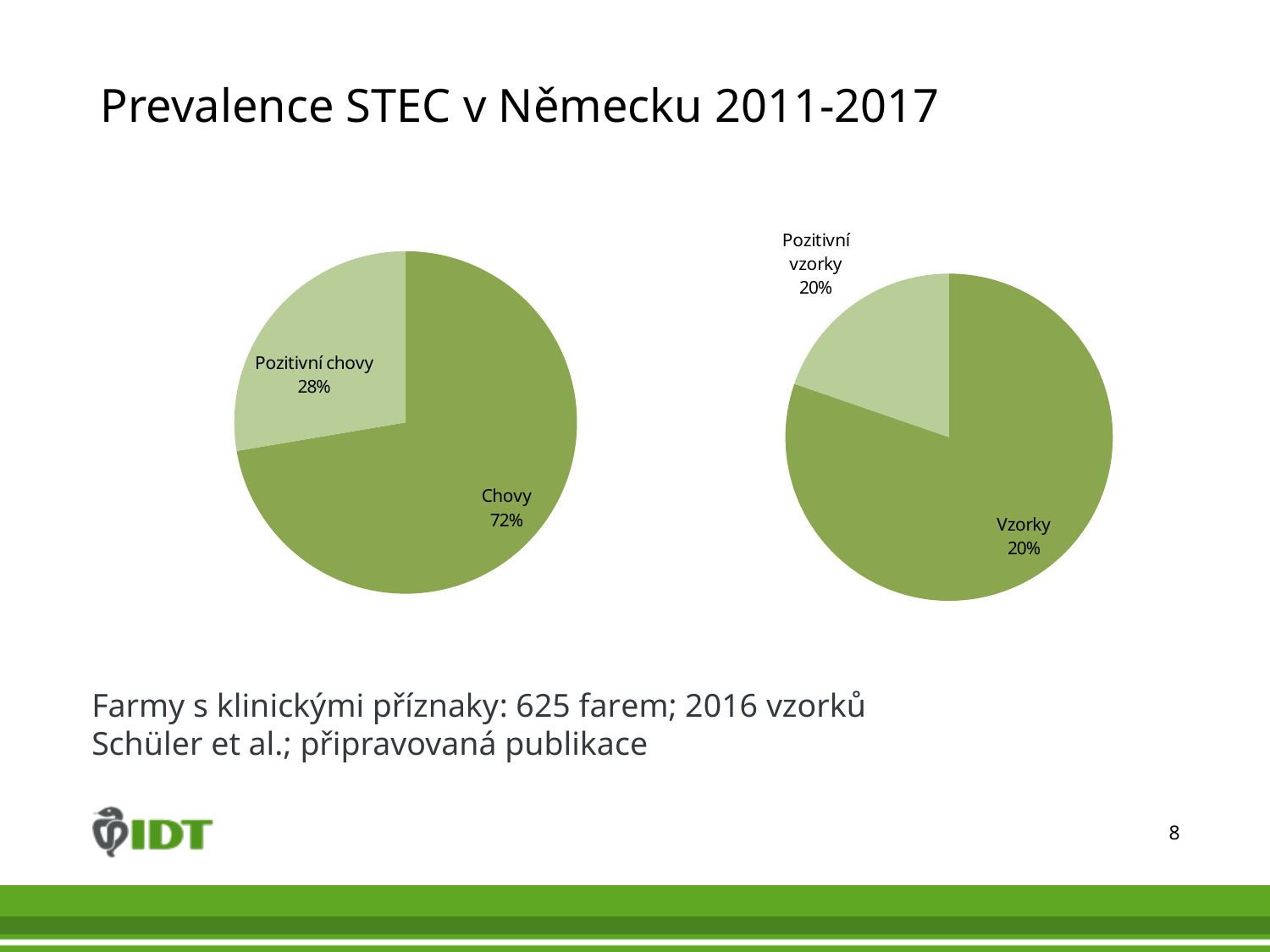
What is the title of the slide containing the two pie charts? Prevalence STEC v Německu 2011-2017 In the left pie chart, what share is labelled for Chovy? 72% In the left pie chart, what share is labelled for Pozitivní chovy? 28% In the left pie chart, which is larger, Chovy or Pozitivní chovy? Chovy How many slices does the left pie chart have? 2 How many pie charts are shown on the slide? 2 In the right pie chart, what share is labelled for Pozitivní vzorky? 20% In the left pie chart, which slice is the largest? Chovy What type of chart is shown on the left of the slide? pie chart In the left pie chart, what is the difference in percentage points between Chovy and Pozitivní chovy? 44 In the left pie chart, which slice is the smallest? Pozitivní chovy How many slices does the right pie chart have? 2